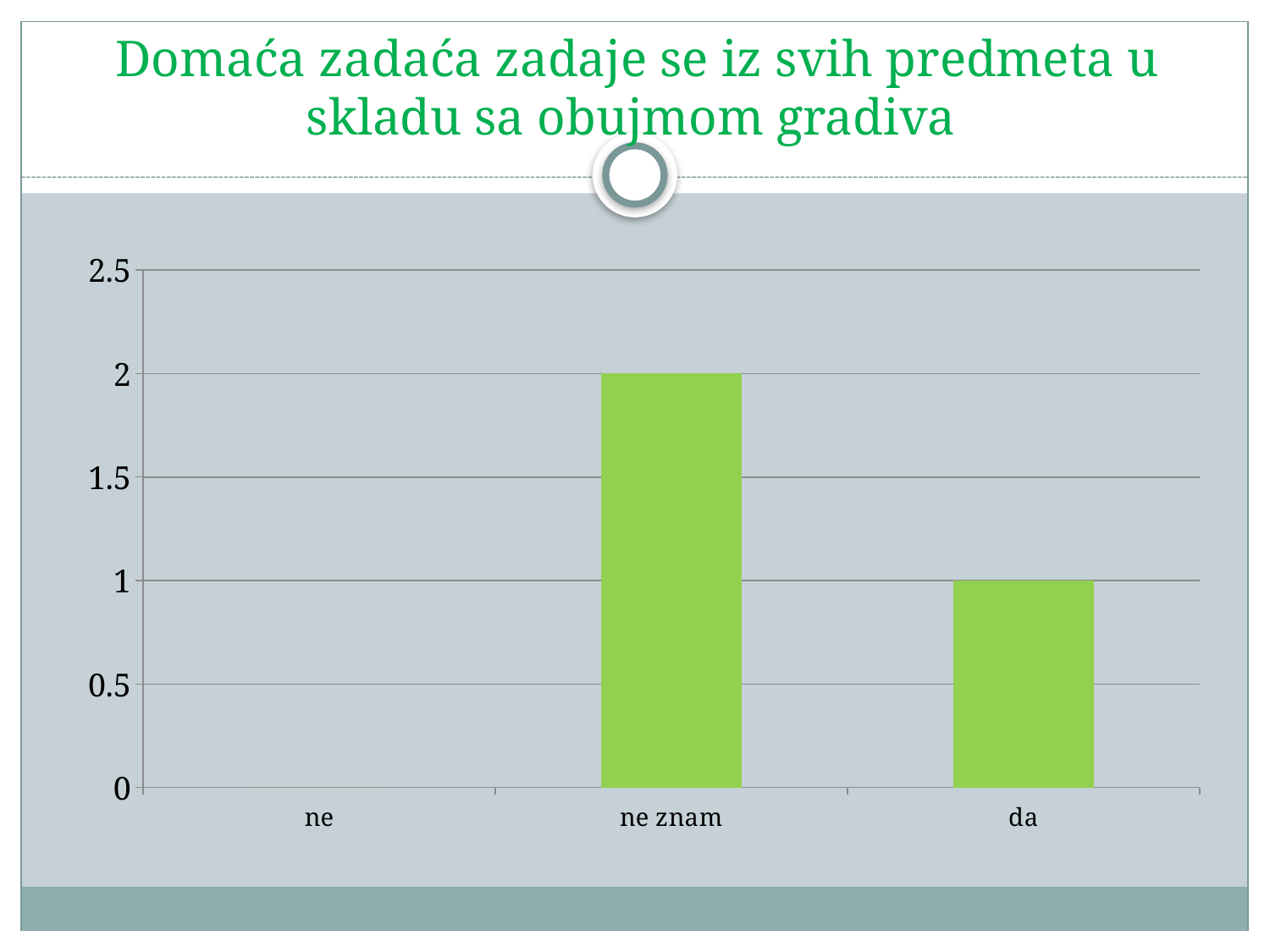
Which category has the lowest value? ne Is the value for "da" greater or less than 1.5? less What is the value for "ne znam"? 2 Which is larger, the value for "da" or the value for "ne znam"? ne znam What is the value for "ne"? 0 How many categories are shown on the x axis? 3 Is the value for "ne znam" greater or less than 1.5? greater What colour are the bars in the chart? green What kind of chart is shown on the slide? bar chart Which category has the highest value? ne znam What is the value for "da"? 1 What is the difference between the values for "ne znam" and "da"? 1